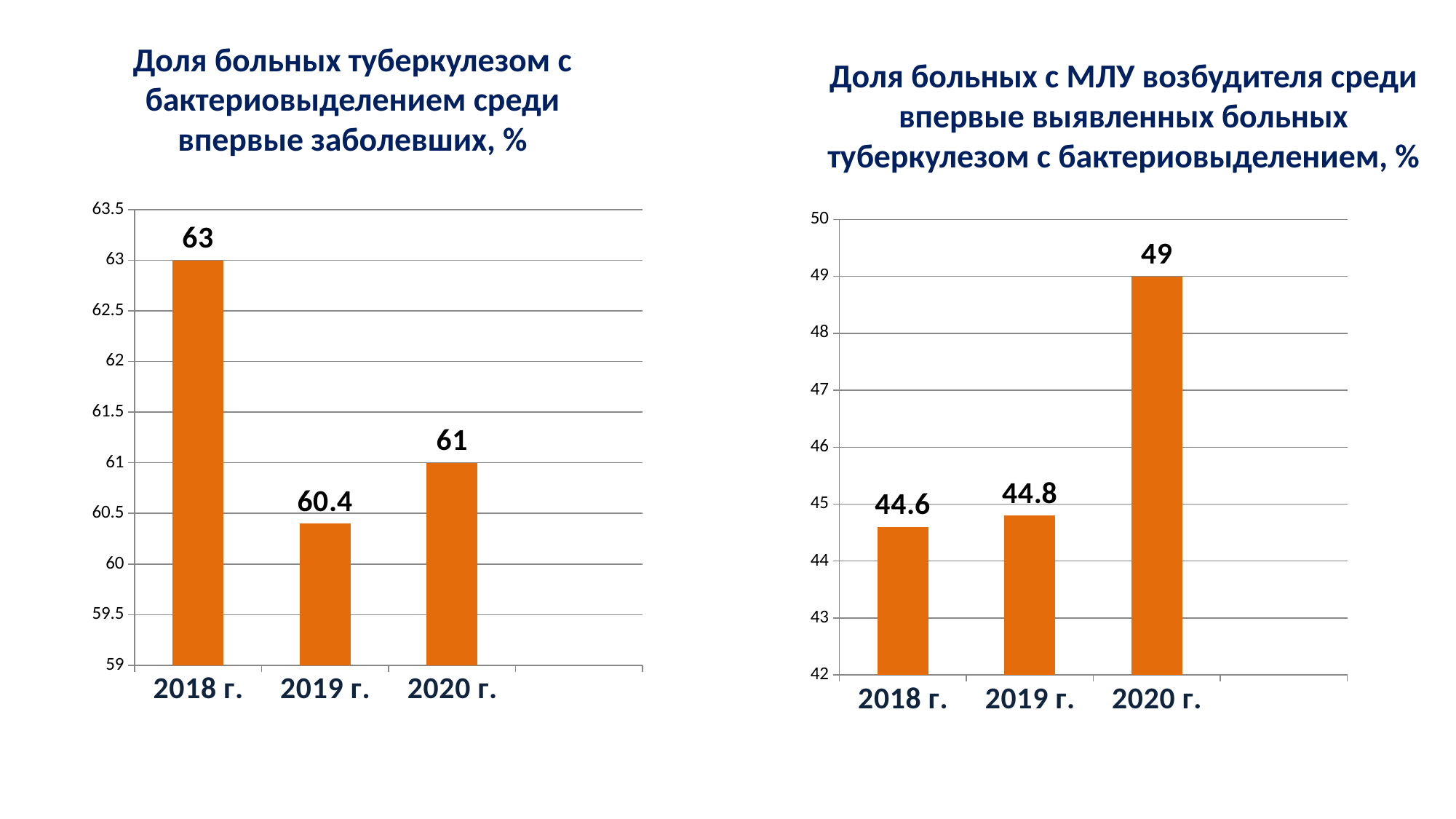
In the right chart (Доля больных с МЛУ возбудителя среди впервые выявленных больных туберкулезом с бактериовыделением, %), what is the value for 2018 г.? 44.6 In the left chart (Доля больных туберкулезом с бактериовыделением среди впервые заболевших, %), what is the value for 2019 г.? 60.4 In the left chart (Доля больных туберкулезом с бактериовыделением среди впервые заболевших, %), what is the value for 2018 г.? 63 What type of chart is the left chart (Доля больных туберкулезом с бактериовыделением среди впервые заболевших, %)? bar chart In the right chart (Доля больных с МЛУ возбудителя среди впервые выявленных больных туберкулезом с бактериовыделением, %), which year has the highest value? 2020 г. In the left chart (Доля больных туберкулезом с бактериовыделением среди впервые заболевших, %), how many bars are plotted? 3 In the left chart (Доля больных туберкулезом с бактериовыделением среди впервые заболевших, %), what is the difference between the values for 2018 г. and 2020 г.? 2 In the right chart (Доля больных с МЛУ возбудителя среди впервые выявленных больных туберкулезом с бактериовыделением, %), what is the value for 2020 г.? 49 In the right chart (Доля больных с МЛУ возбудителя среди впервые выявленных больных туберкулезом с бактериовыделением, %), is the value for 2019 г. greater or less than 45? less In the left chart (Доля больных туберкулезом с бактериовыделением среди впервые заболевших, %), which year has the lowest value? 2019 г. In the right chart (Доля больных с МЛУ возбудителя среди впервые выявленных больных туберкулезом с бактериовыделением, %), do the values rise or fall from 2018 г. to 2020 г.? rise In the right chart (Доля больных с МЛУ возбудителя среди впервые выявленных больных туберкулезом с бактериовыделением, %), what is the difference between the values for 2020 г. and 2019 г.? 4.2